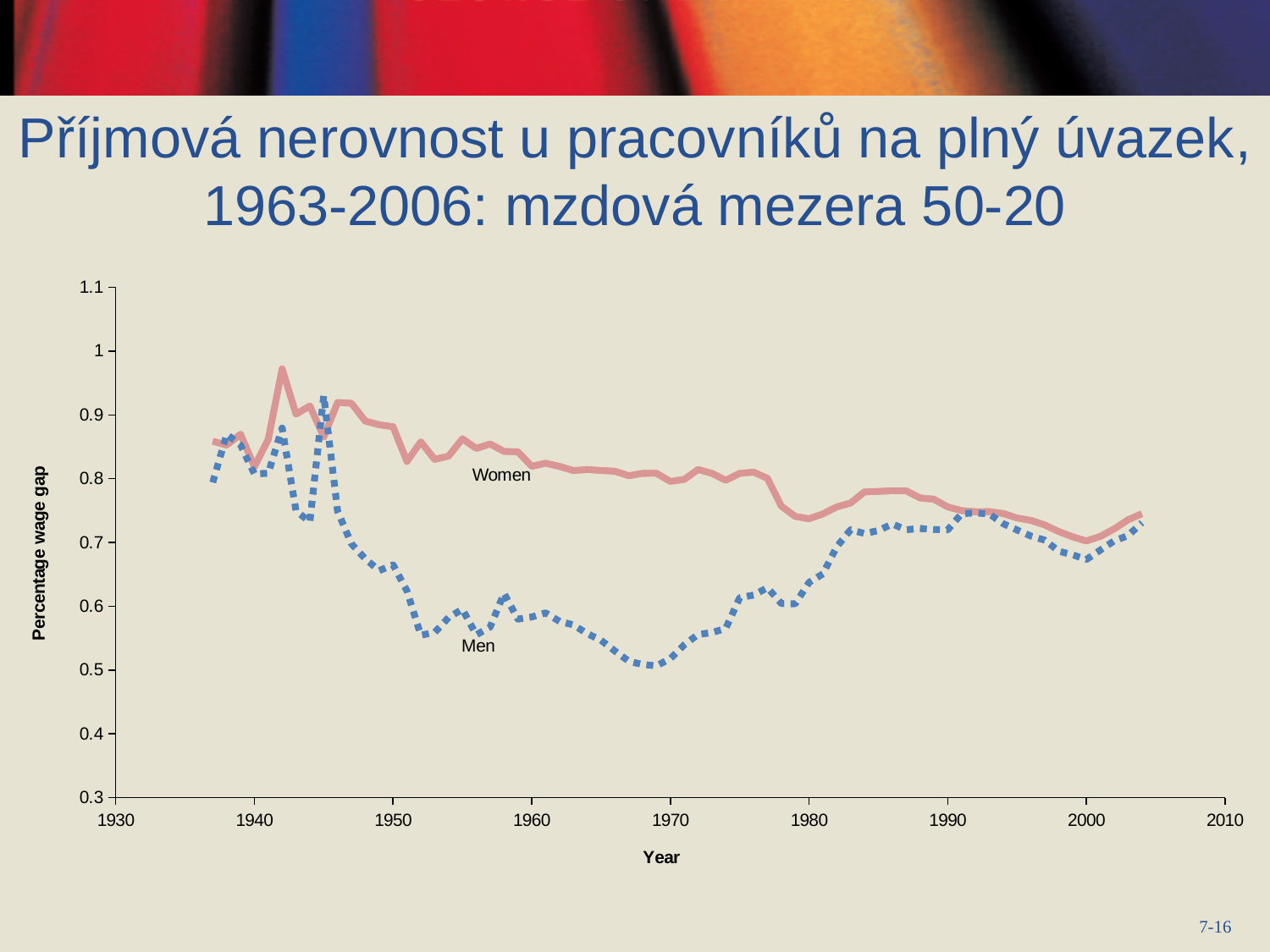
Is the value for Women around 1950 greater or less than 0.8? greater Is the value for Men around 1950 greater or less than 0.7? less Is the value for Women around 1980 greater or less than 0.8? less What are the names of the two series plotted on the chart? Women and Men Does the Men series rise or fall between 1950 and 1968? fall How many data series are plotted on the chart? 2 Around 1970, which series has the higher value, Women or Men? Women In which decade does the Men series reach its lowest point? 1960s What kind of chart is shown on the slide? line chart Does the Women series rise or fall overall between 1950 and 2000? fall What is the title of the vertical axis? Percentage wage gap